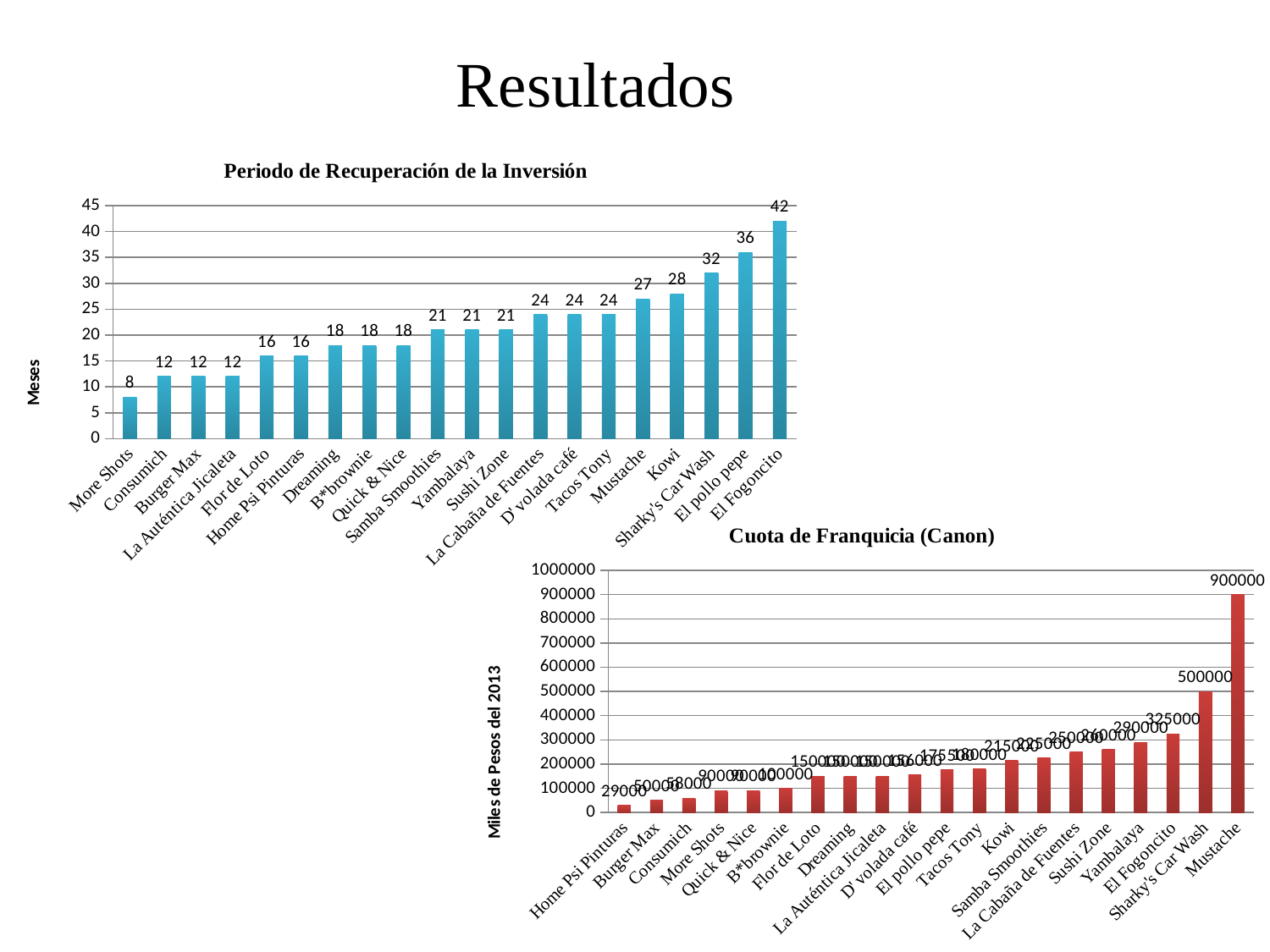
In the 'Cuota de Franquicia (Canon)' chart, is the value for El Fogoncito greater or less than 300000? greater In the 'Cuota de Franquicia (Canon)' chart, what is the value for Mustache? 900000 In the 'Periodo de Recuperación de la Inversión' chart, what is the difference between El pollo pepe and Sharky's Car Wash? 4 In the 'Cuota de Franquicia (Canon)' chart, what is the value for Sharky's Car Wash? 500000 In the 'Periodo de Recuperación de la Inversión' chart, what is the value for El Fogoncito? 42 In the 'Periodo de Recuperación de la Inversión' chart, which category has the lowest value? More Shots In the 'Periodo de Recuperación de la Inversión' chart, what is the value for More Shots? 8 In the 'Periodo de Recuperación de la Inversión' chart, which category has the highest value? El Fogoncito In the 'Periodo de Recuperación de la Inversión' chart, do the values rise or fall from left to right? rise In the 'Periodo de Recuperación de la Inversión' chart, how many categories are shown? 20 In the 'Periodo de Recuperación de la Inversión' chart, which is larger, Kowi or Mustache? Kowi What type of chart is 'Cuota de Franquicia (Canon)'? bar chart